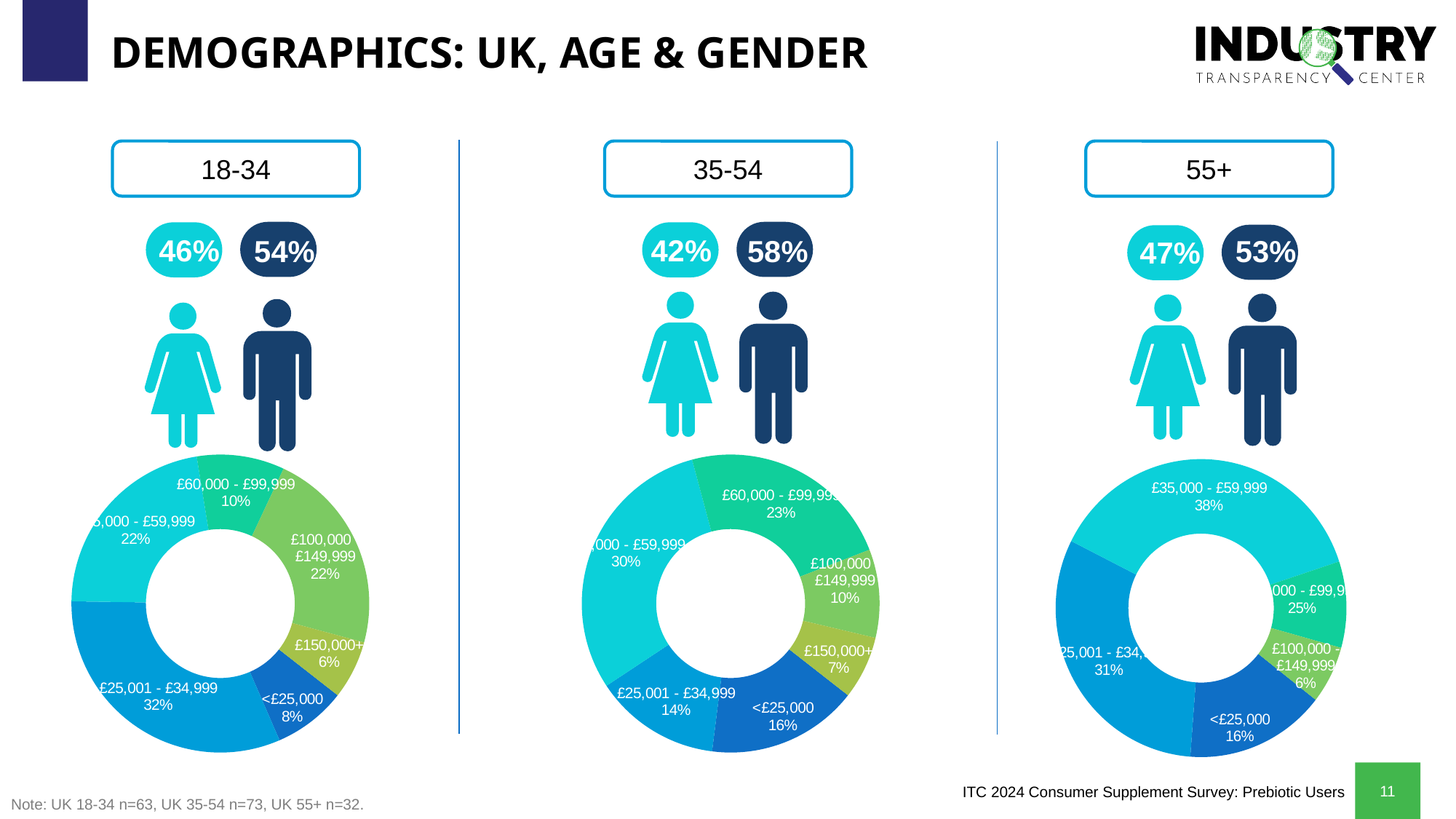
In the 18-34 donut chart, which income bracket has the smallest share? £150,000+ In the 35-54 donut chart, what share of respondents earn £60,000 - £99,999? 23% What percentage of the 35-54 age group is male, according to the slide? 58% What type of chart is used to show income brackets for each age group? Donut (pie) chart How many income bracket slices does the 35-54 donut chart show? 6 In the 55+ donut chart, what share of respondents earn £35,000 - £59,999? 38% What percentage of the 55+ age group is female, according to the slide? 47% In the 18-34 donut chart, what share of respondents earn £25,001 - £34,999? 32% In the 35-54 donut chart, which is larger: the <£25,000 slice or the £25,001 - £34,999 slice? <£25,000 In the 55+ donut chart, which income bracket has the smallest share? £100,000 - £149,999 In the 35-54 donut chart, which income bracket has the largest share? £35,000 - £59,999 In the 18-34 donut chart, what is the difference in percentage points between the £25,001 - £34,999 slice and the <£25,000 slice? 24 percentage points